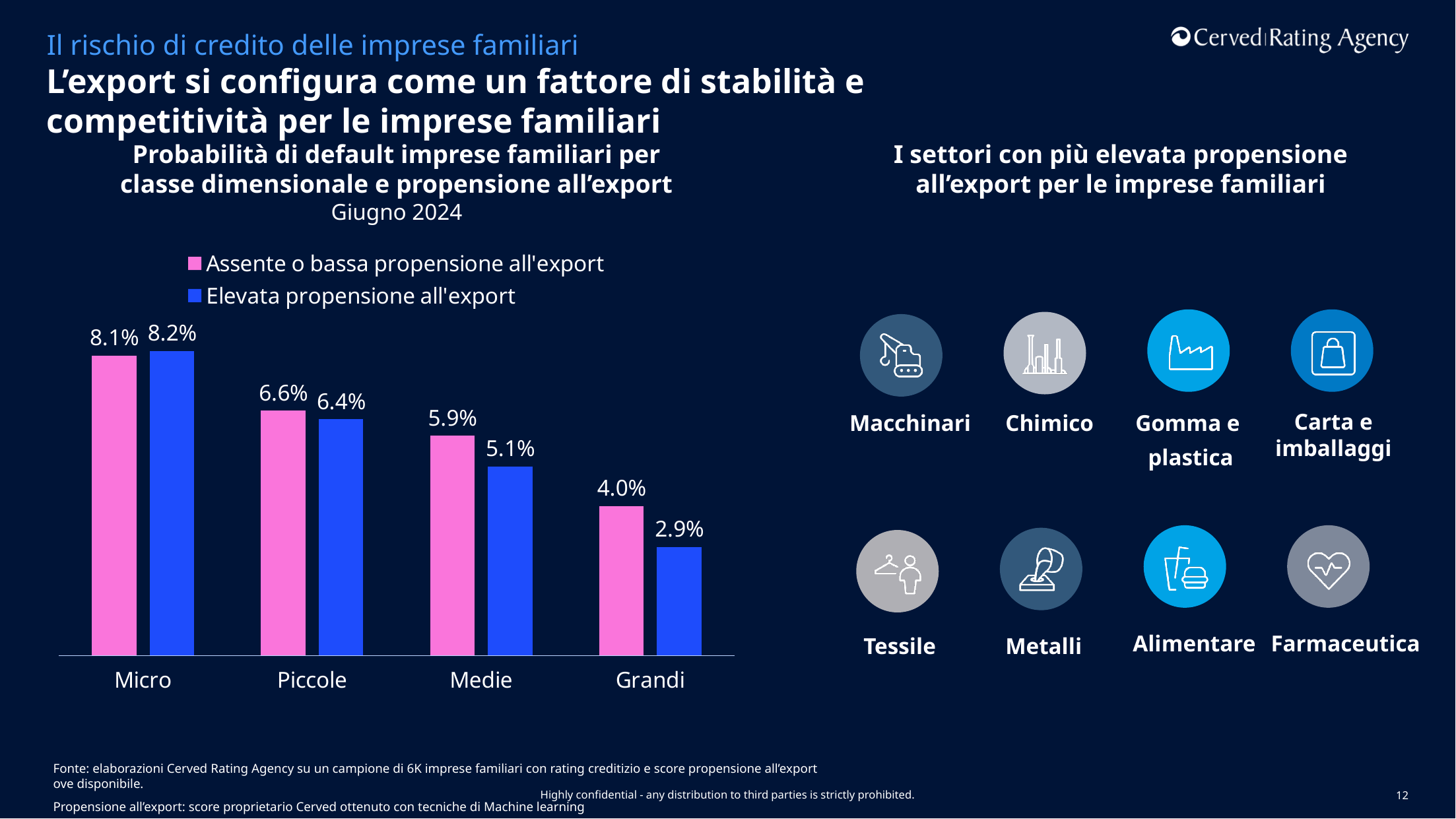
How many series does the legend list? 2 How many size classes are shown on the x axis? 4 For Piccole firms, which series has the larger default probability? Assente o bassa propensione all'export What is the default probability for Grandi firms with 'Assente o bassa propensione all'export'? 4.0% What is the default probability for Medie firms with 'Elevata propensione all'export'? 5.1% Which size class has the lowest default probability for 'Elevata propensione all'export'? Grandi What type of chart is shown on the slide? Bar chart Which size class has the highest default probability for 'Assente o bassa propensione all'export'? Micro What is the difference between the two series for Grandi firms? 1.1% What is the difference between the two series for Medie firms? 0.8% What is the default probability for Micro firms with 'Elevata propensione all'export'? 8.2% Do the values for 'Elevata propensione all'export' rise or fall from Micro to Grandi? Fall